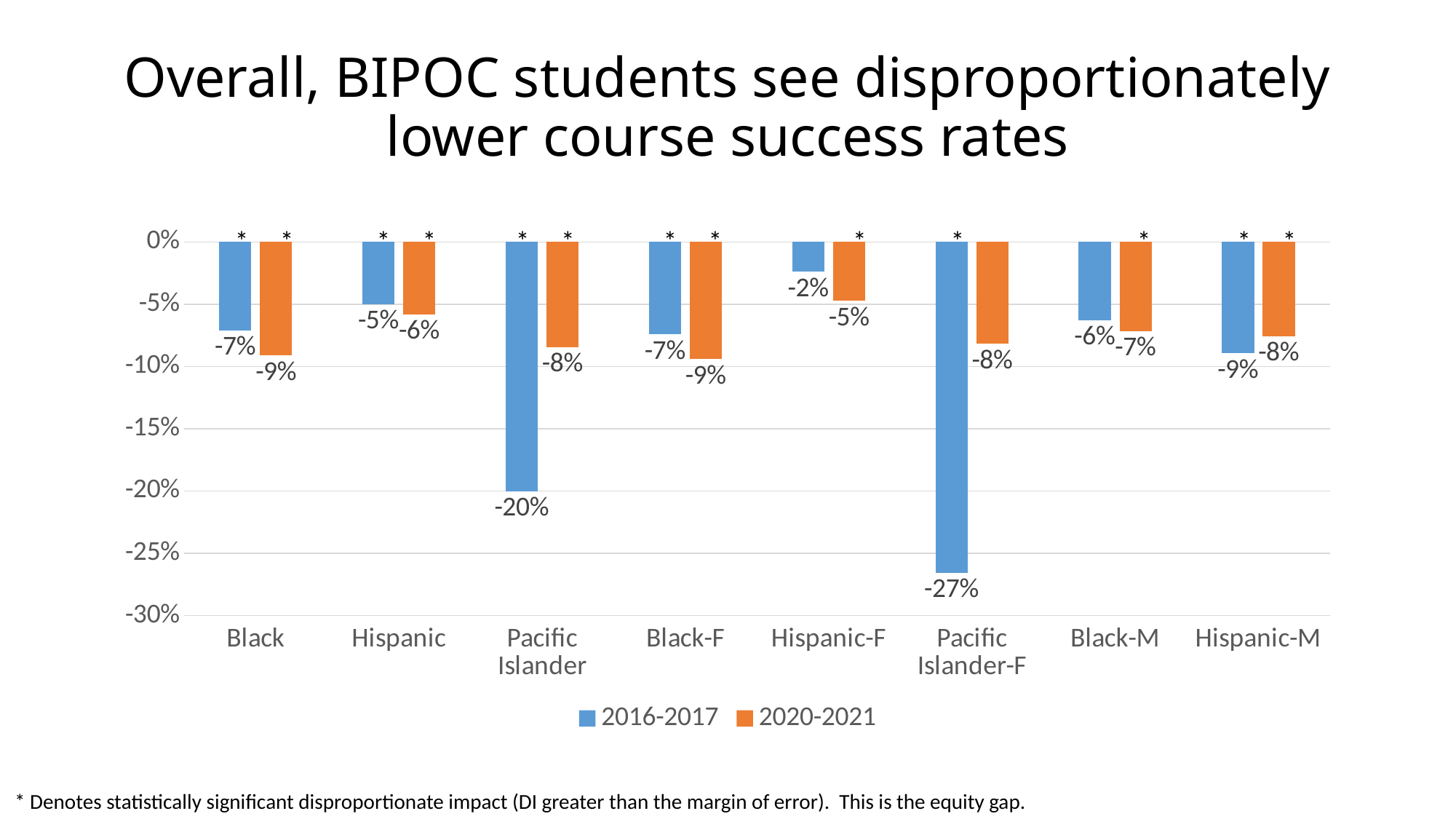
How many series does the legend list? 2 What is the difference between the 2016-2017 and 2020-2021 values for Pacific Islander-F? 19 percentage points What is the value for Pacific Islander in the 2016-2017 series? -20% What is the difference between the 2016-2017 and 2020-2021 values for Black? 2 percentage points How many categories are shown on the x axis? 8 Which is lower, the 2016-2017 value for Hispanic-M or the 2020-2021 value for Hispanic-M? 2016-2017 What kind of chart is shown on the slide? Bar chart What is the value for Hispanic-F in the 2020-2021 series? -5% Which colour represents the 2020-2021 series? Orange Which category has the highest (least negative) value in the 2016-2017 series? Hispanic-F Which category has the lowest value in the 2016-2017 series? Pacific Islander-F What is the value for Black-M in the 2016-2017 series? -6%